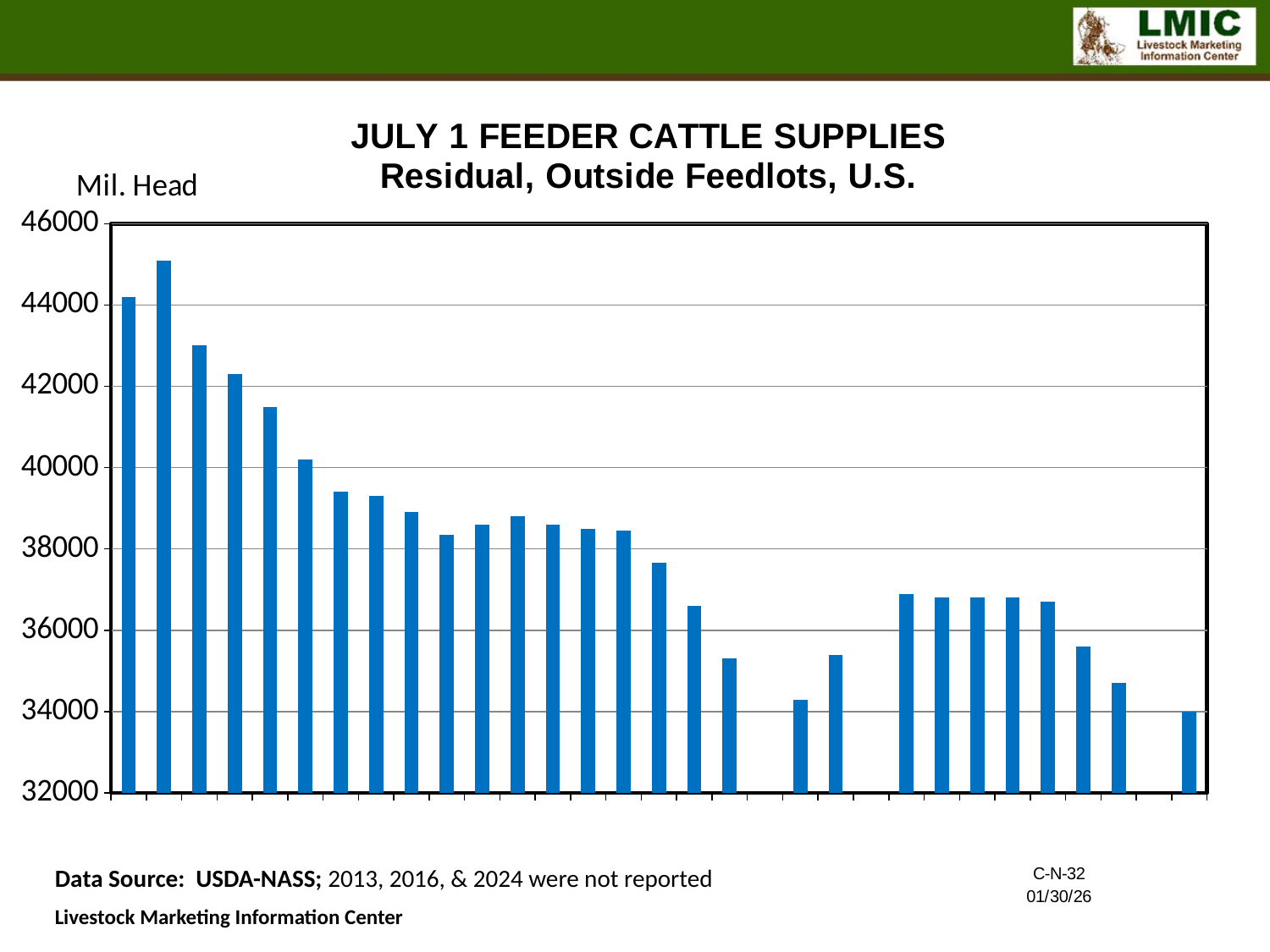
Which bar is the tallest in the chart: the first bar from the left or the second bar from the left? The second bar from the left What is the highest value shown on the vertical axis of the chart? 46000 What is the title of the chart? JULY 1 FEEDER CATTLE SUPPLIES Residual, Outside Feedlots, U.S. Is the value of the tallest bar greater or less than 44000? greater Is the value of the last (rightmost) bar greater or less than 36000? less What unit label is shown above the vertical axis of the chart? Mil. Head What kind of chart is shown on the slide? Bar chart How many bars are plotted in the chart? 28 Is the value of the first (leftmost) bar greater or less than 44000? greater Which is larger, the value of the first bar from the left or the value of the last bar on the right? The first bar from the left Do the bar values generally rise or fall from left to right across the chart? Fall